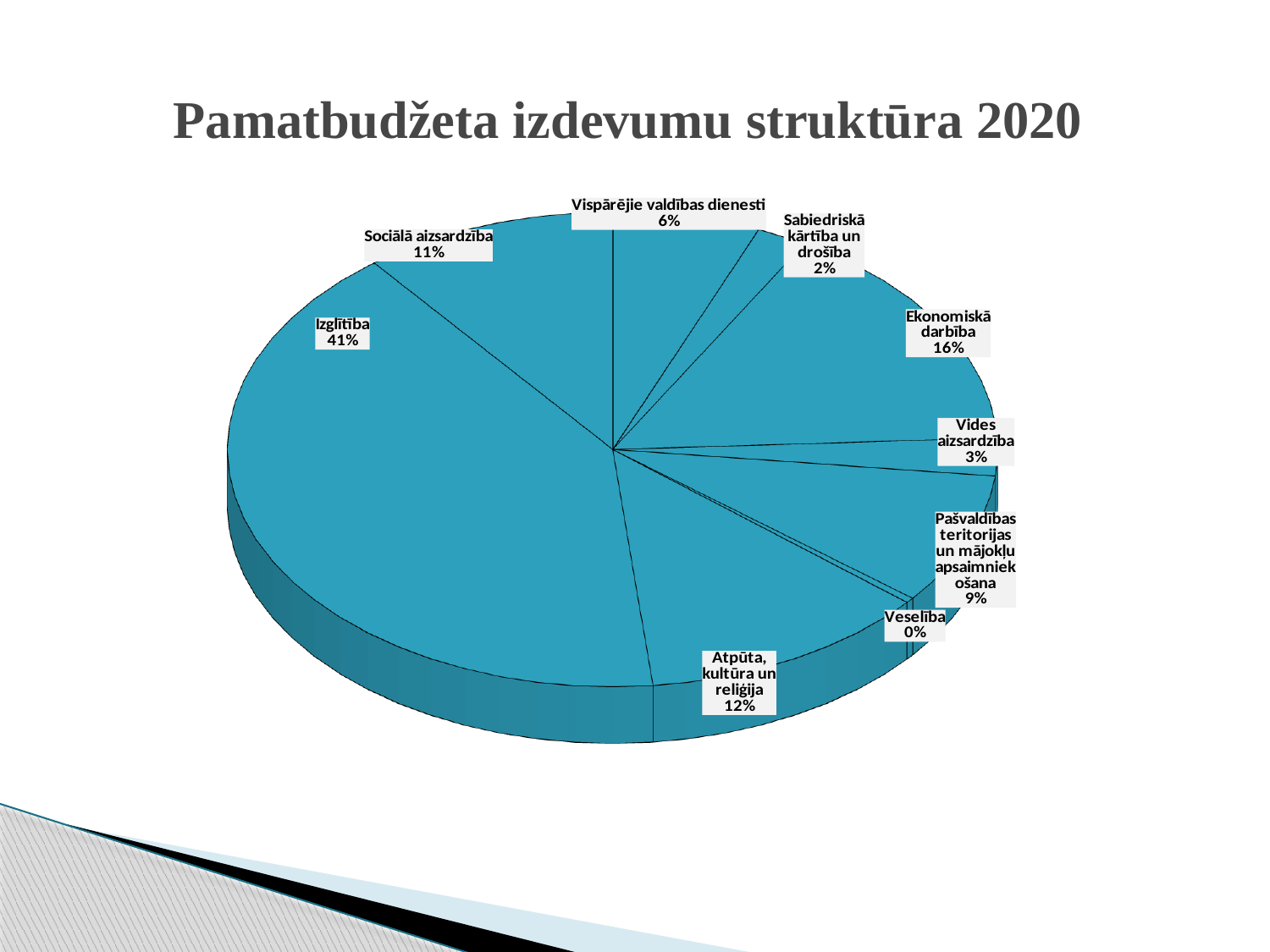
What is the difference in percentage points between Izglītība and Ekonomiskā darbība? 25 What kind of chart is shown on the slide? pie chart What share of the pie does Atpūta, kultūra un reliģija have? 12% Which category has the largest share of the pie? Izglītība What share of the pie does Izglītība have? 41% Which category has the smallest share of the pie? Veselība What share of the pie does Vides aizsardzība have? 3% What is the title of the chart? Pamatbudžeta izdevumu struktūra 2020 Which is larger, the share for Sociālā aizsardzība or the share for Vispārējie valdības dienesti? Sociālā aizsardzība How many slices does the pie chart have? 9